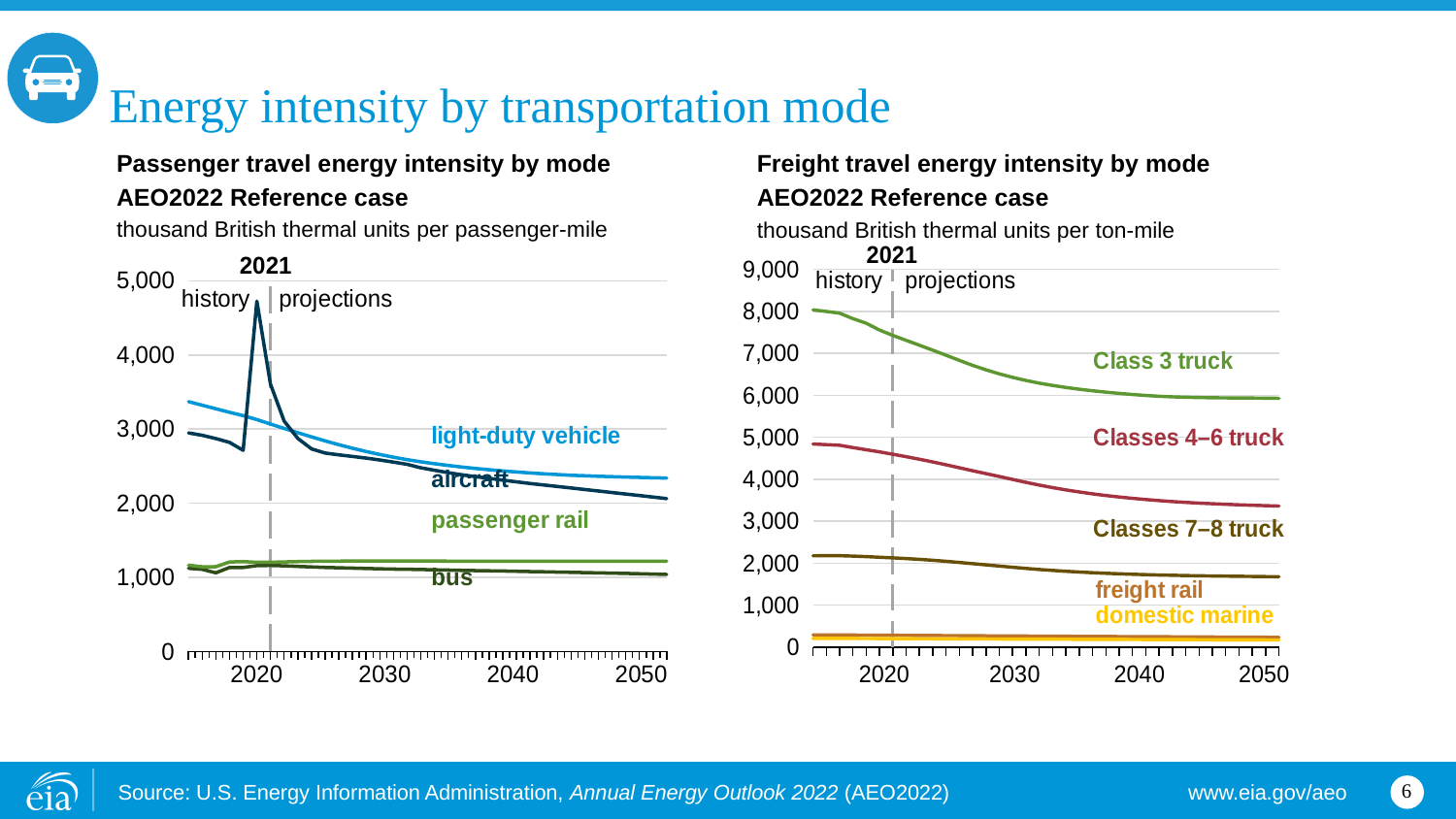
In the 'Passenger travel energy intensity by mode' chart, is the peak value for aircraft around 2020 greater or less than 4,000? greater In the 'Freight travel energy intensity by mode' chart, does the energy intensity of Class 3 truck rise or fall from 2020 to 2050? fall In the 'Passenger travel energy intensity by mode' chart, is the value for light-duty vehicle in 2050 greater or less than 2,000? greater What kind of chart is the 'Passenger travel energy intensity by mode' chart? line chart How many transportation modes are plotted in the 'Freight travel energy intensity by mode' chart? 5 In the 'Passenger travel energy intensity by mode' chart, which has higher energy intensity in 2050, light-duty vehicle or bus? light-duty vehicle In the 'Freight travel energy intensity by mode' chart, is the value for Classes 4–6 truck in 2050 greater or less than 4,000? less How many transportation modes are plotted in the 'Passenger travel energy intensity by mode' chart? 4 In the 'Freight travel energy intensity by mode' chart, which mode has the highest energy intensity throughout the period? Class 3 truck What unit is used on the 'Passenger travel energy intensity by mode' chart? thousand British thermal units per passenger-mile In which year does the dashed line separating history from projections fall on both charts? 2021